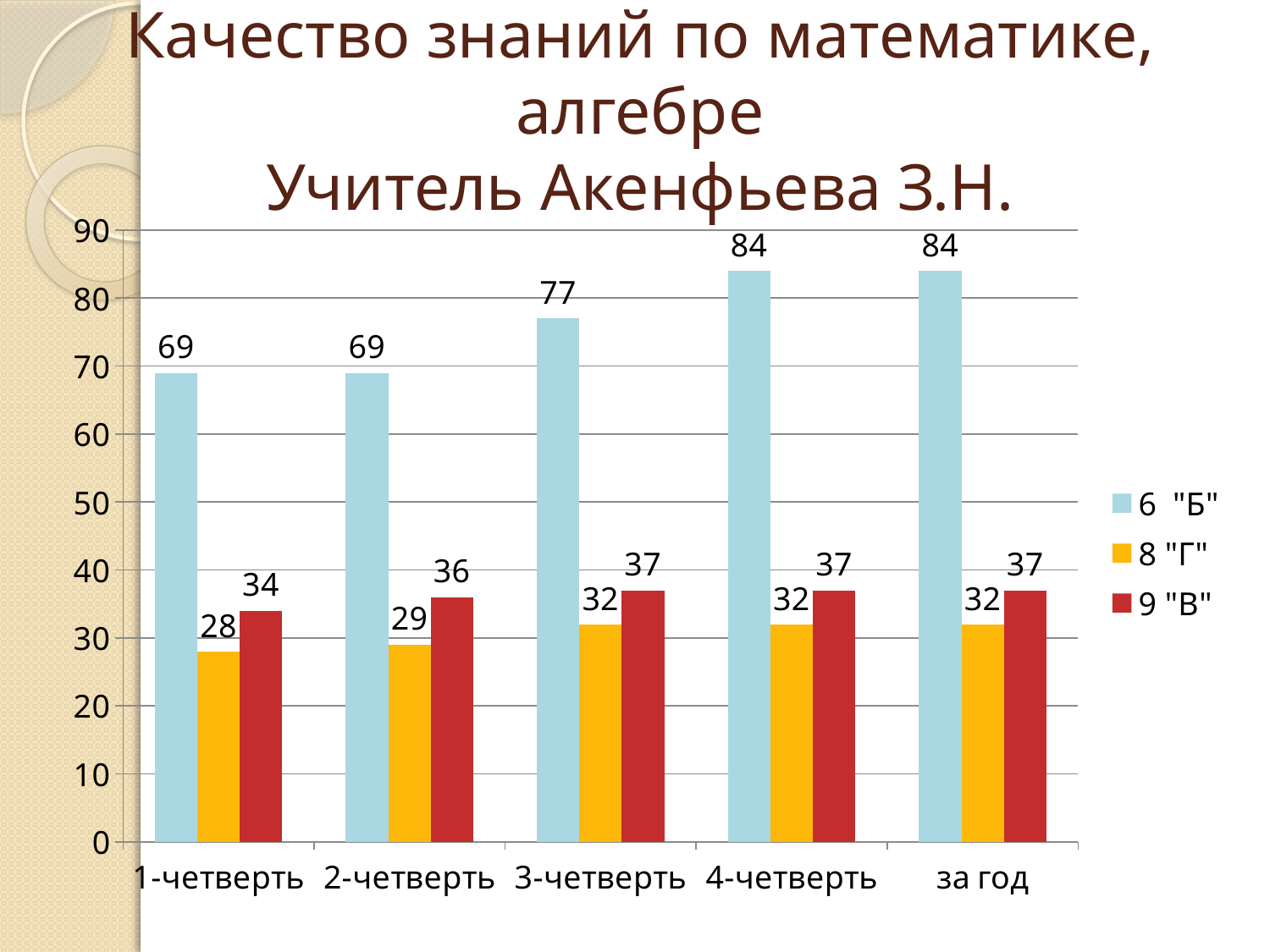
Do the values for 8 "Г" rise or fall from 1-четверть to 4-четверть? rise What is the value for 8 "Г" in 1-четверть? 28 How many categories are shown on the x axis? 5 What is the value for 9 "В" за год? 37 Which series has the lowest value in 2-четверть? 8 "Г" What kind of chart is shown on the slide? bar chart What is the difference between the 6 "Б" values in 4-четверть and 1-четверть? 15 Which series has the highest value in 4-четверть? 6 "Б" What is the value for 9 "В" in 2-четверть? 36 What is the value for 6 "Б" in 3-четверть? 77 Which is larger: 9 "В" in 1-четверть or 8 "Г" in 3-четверть? 9 "В" in 1-четверть How many series does the legend list? 3